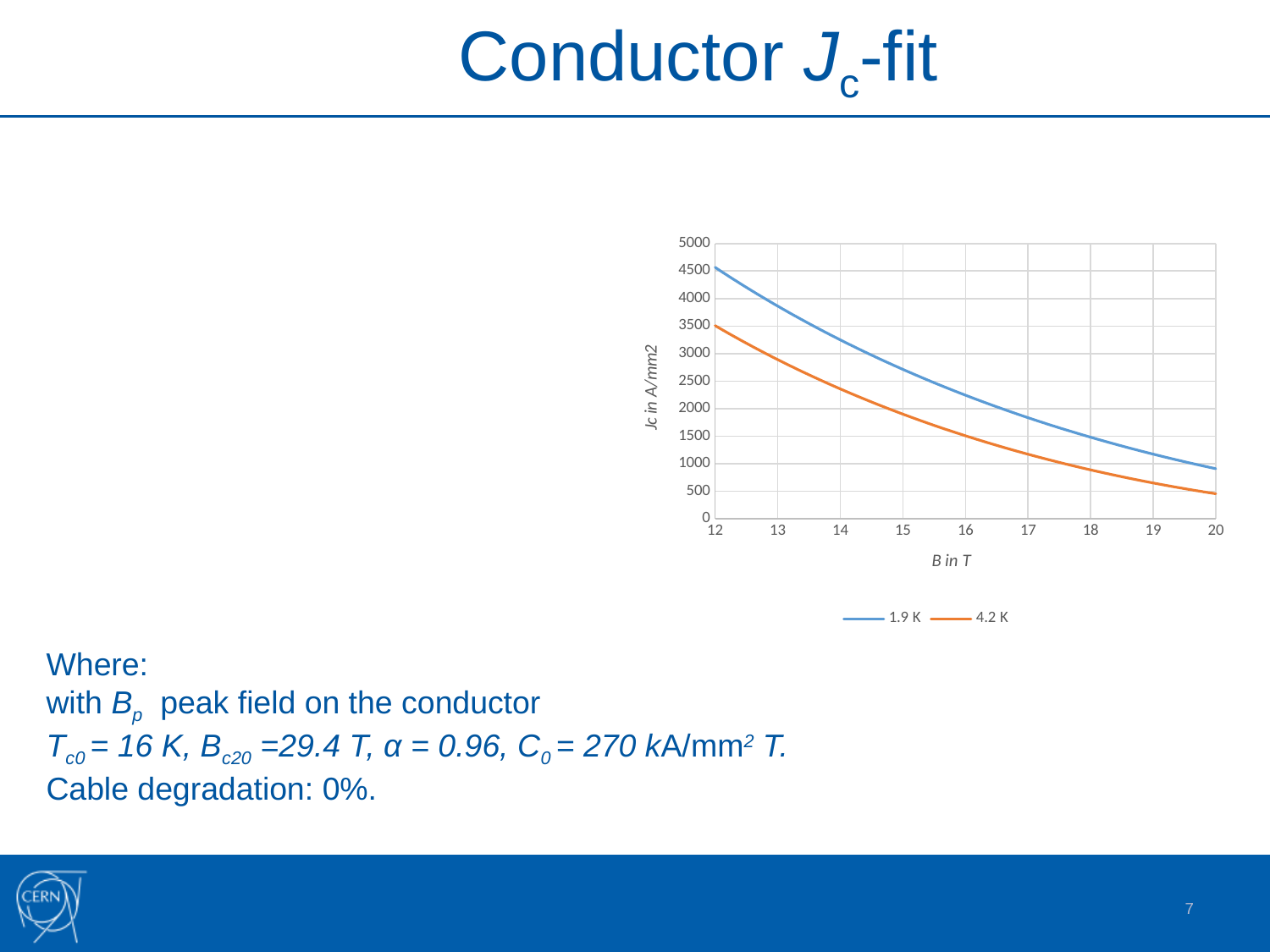
How many series does the chart legend list? 2 Do the values of the 1.9 K series rise or fall as B increases from 12 to 20 T? fall What kind of chart is shown on the slide? line chart What is the label of the x axis of the chart? B in T Is the value for the 1.9 K series at B = 12 T greater or less than 4000? greater Is the value for the 4.2 K series at B = 12 T greater or less than 3000? greater At B = 15 T, which series has the higher Jc value, 1.9 K or 4.2 K? 1.9 K Do the values of the 4.2 K series rise or fall along the x axis? fall Is the value for the 4.2 K series at B = 16 T greater or less than 2000? less What are the two series named in the chart legend? 1.9 K and 4.2 K